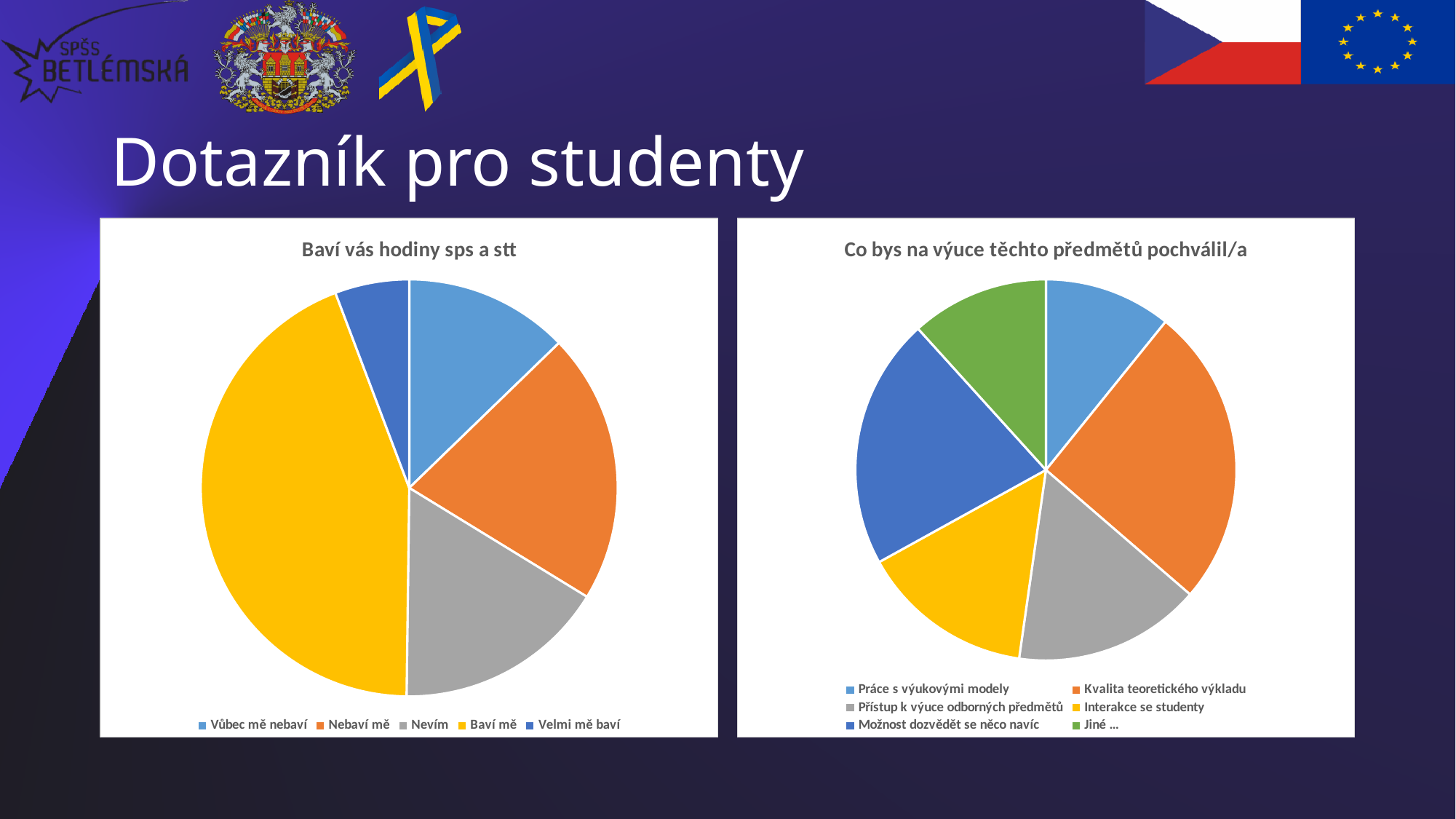
What kind of chart is the chart titled "Baví vás hodiny sps a stt"? pie chart In the chart titled "Co bys na výuce těchto předmětů pochválil/a", how many slices does the pie have? 6 In the chart titled "Baví vás hodiny sps a stt", what colour is the "Baví mě" slice? yellow In the chart titled "Co bys na výuce těchto předmětů pochválil/a", which category has the largest slice? Kvalita teoretického výkladu In the chart titled "Baví vás hodiny sps a stt", which slice is larger: "Baví mě" or "Nebaví mě"? Baví mě In the chart titled "Baví vás hodiny sps a stt", which slice is larger: "Nebaví mě" or "Velmi mě baví"? Nebaví mě What kind of chart is the chart titled "Co bys na výuce těchto předmětů pochválil/a"? pie chart In the chart titled "Co bys na výuce těchto předmětů pochválil/a", which slice is larger: "Kvalita teoretického výkladu" or "Jiné …"? Kvalita teoretického výkladu In the chart titled "Baví vás hodiny sps a stt", which category has the smallest slice? Velmi mě baví In the chart titled "Baví vás hodiny sps a stt", which category has the largest slice? Baví mě In the chart titled "Baví vás hodiny sps a stt", how many slices does the pie have? 5